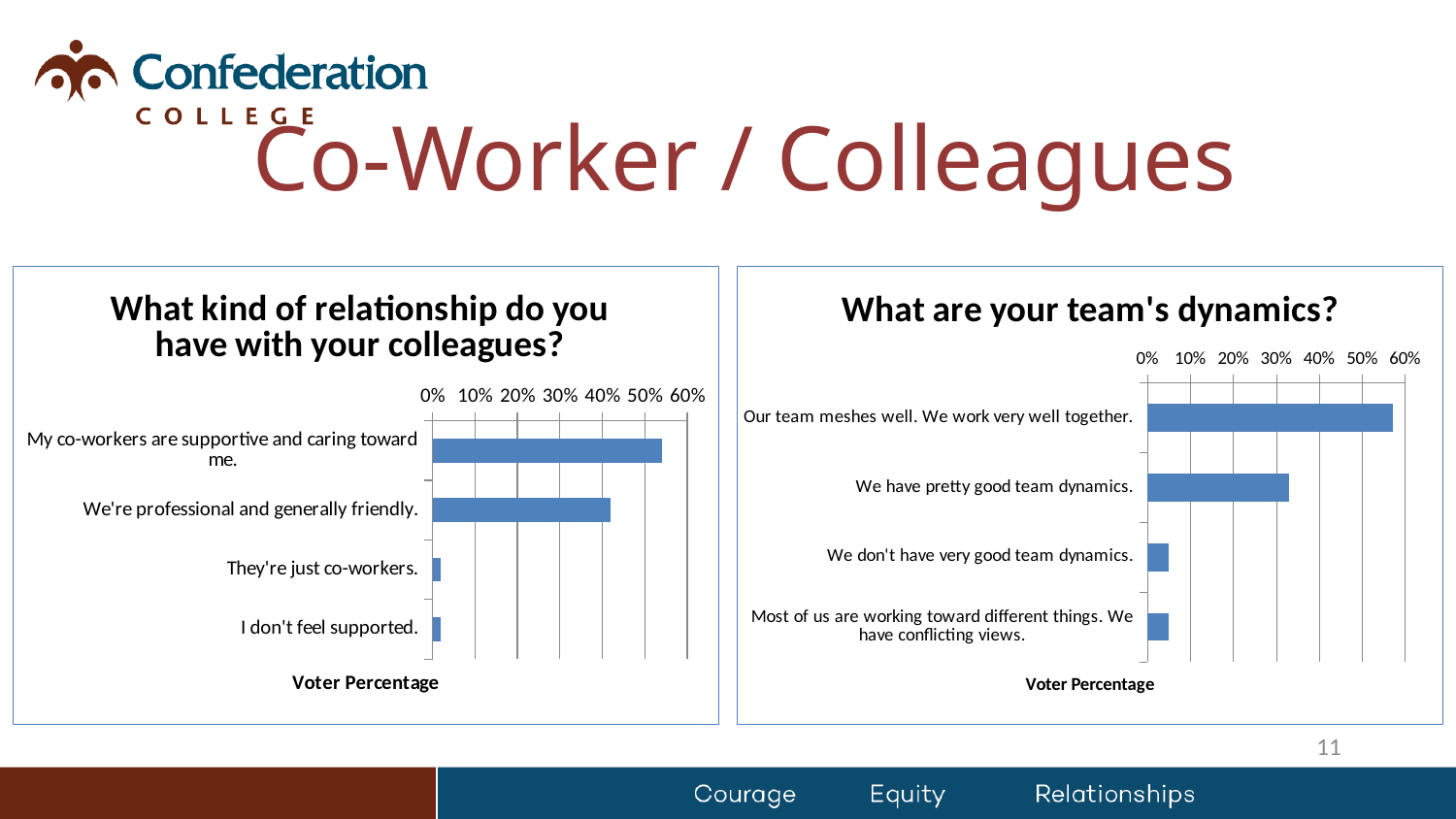
In the chart titled "What kind of relationship do you have with your colleagues?", which category has the highest value? My co-workers are supportive and caring toward me. In the chart titled "What are your team's dynamics?", which is larger: the value for "We have pretty good team dynamics." or the value for "We don't have very good team dynamics."? We have pretty good team dynamics. In the chart titled "What kind of relationship do you have with your colleagues?", which is larger: the value for "My co-workers are supportive and caring toward me." or the value for "We're professional and generally friendly."? My co-workers are supportive and caring toward me. In the chart titled "What are your team's dynamics?", is the value for "Our team meshes well. We work very well together." greater or less than 50%? greater In the chart titled "What kind of relationship do you have with your colleagues?", is the value for "We're professional and generally friendly." greater or less than 30%? greater How many categories are shown in the chart titled "What kind of relationship do you have with your colleagues?"? 4 In the chart titled "What are your team's dynamics?", which category has the highest value? Our team meshes well. We work very well together. What is the axis title shown below the bars in the chart titled "What are your team's dynamics?"? Voter Percentage In the chart titled "What are your team's dynamics?", is the value for "We have pretty good team dynamics." greater or less than 40%? less What kind of chart is the chart titled "What kind of relationship do you have with your colleagues?"? bar chart How many categories are shown in the chart titled "What are your team's dynamics?"? 4